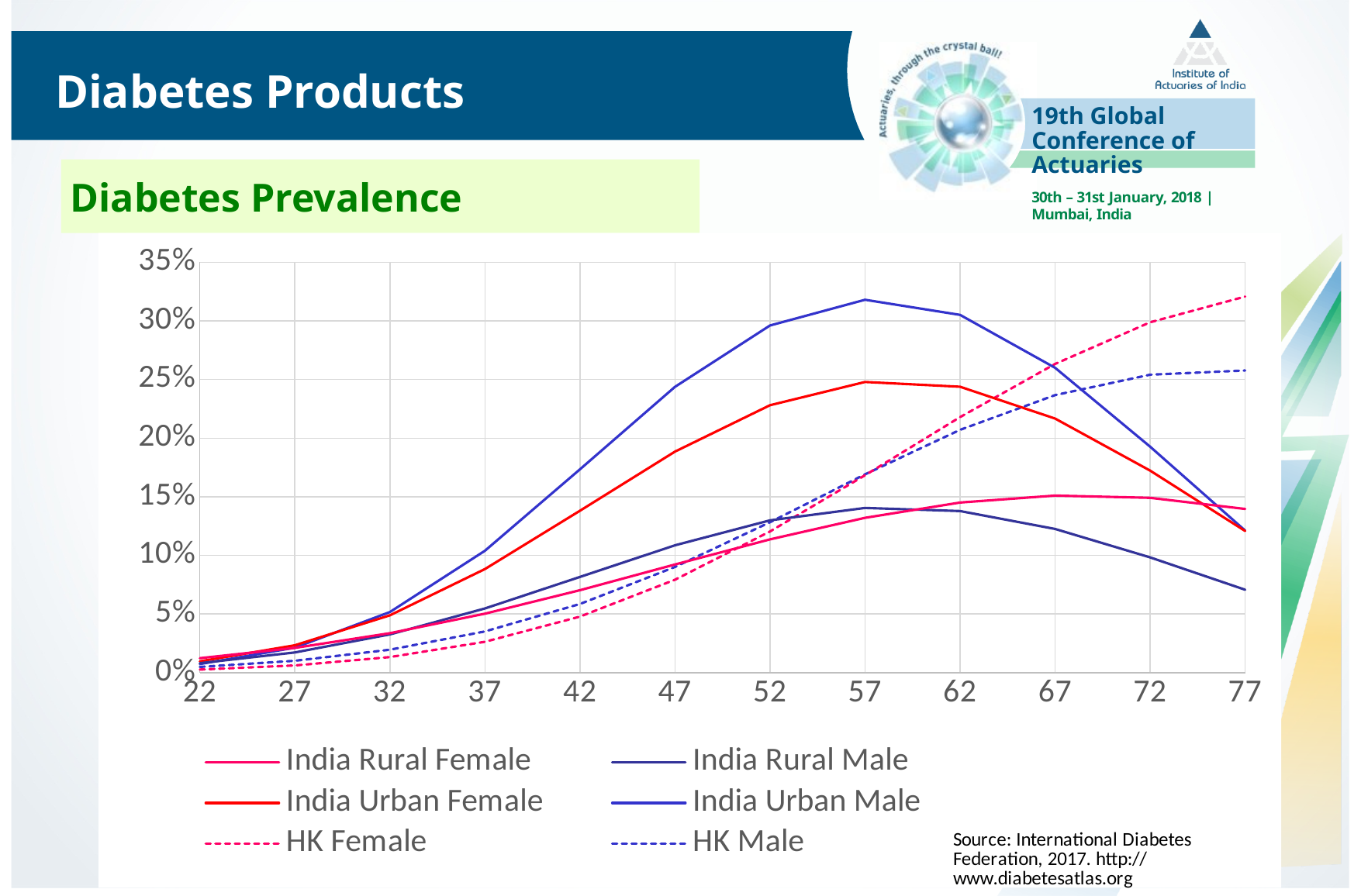
Does the HK Female series rise or fall as age increases from 22 to 77? rises Is the value for India Rural Male at age 77 greater or less than 10%? less Is the value for HK Female at age 77 greater or less than 30%? greater Which series has the lowest value at age 77? India Rural Male How many age points are labelled on the x axis? 12 At age 67, which is larger: HK Female or India Urban Female? HK Female Is the value for India Urban Female at age 57 greater or less than 20%? greater How many series does the legend list? 6 Which series has the highest value at age 77? HK Female At age 57, which is larger: India Urban Male or India Urban Female? India Urban Male What kind of chart is shown on the slide? line chart